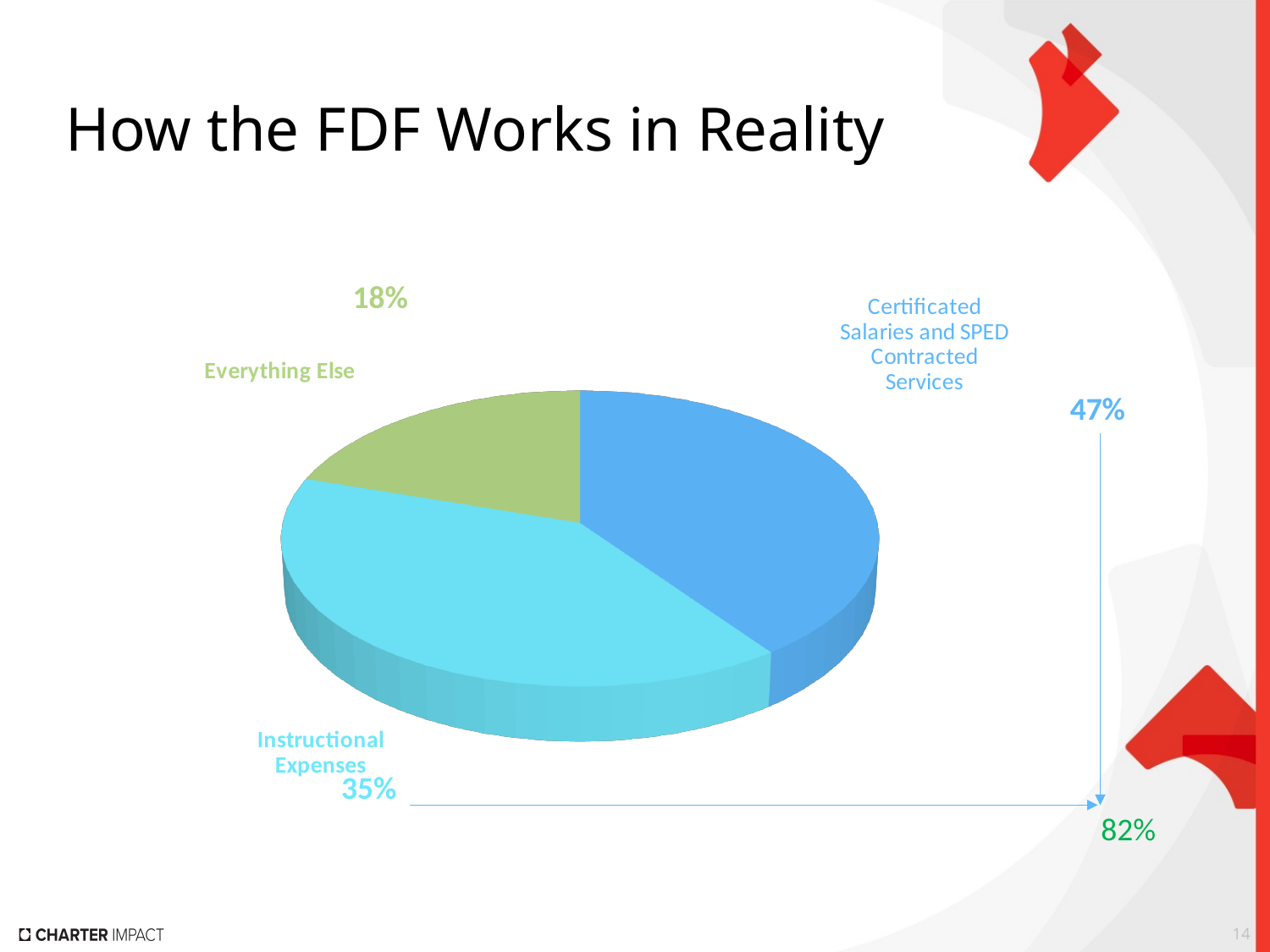
What is the title of the slide containing the pie chart? How the FDF Works in Reality What share of the pie is Certificated Salaries and SPED Contracted Services? 47% Which slice of the pie is the smallest? Everything Else What is the combined share of Certificated Salaries and SPED Contracted Services and Instructional Expenses? 82% What is the difference between the Certificated Salaries and SPED Contracted Services share and the Instructional Expenses share? 12% What is the difference between the Instructional Expenses share and the Everything Else share? 17% How many slices does the pie chart have? 3 What share of the pie is Everything Else? 18% What share of the pie is Instructional Expenses? 35% Which is larger, the Instructional Expenses slice or the Everything Else slice? Instructional Expenses What kind of chart is shown on the slide? pie chart